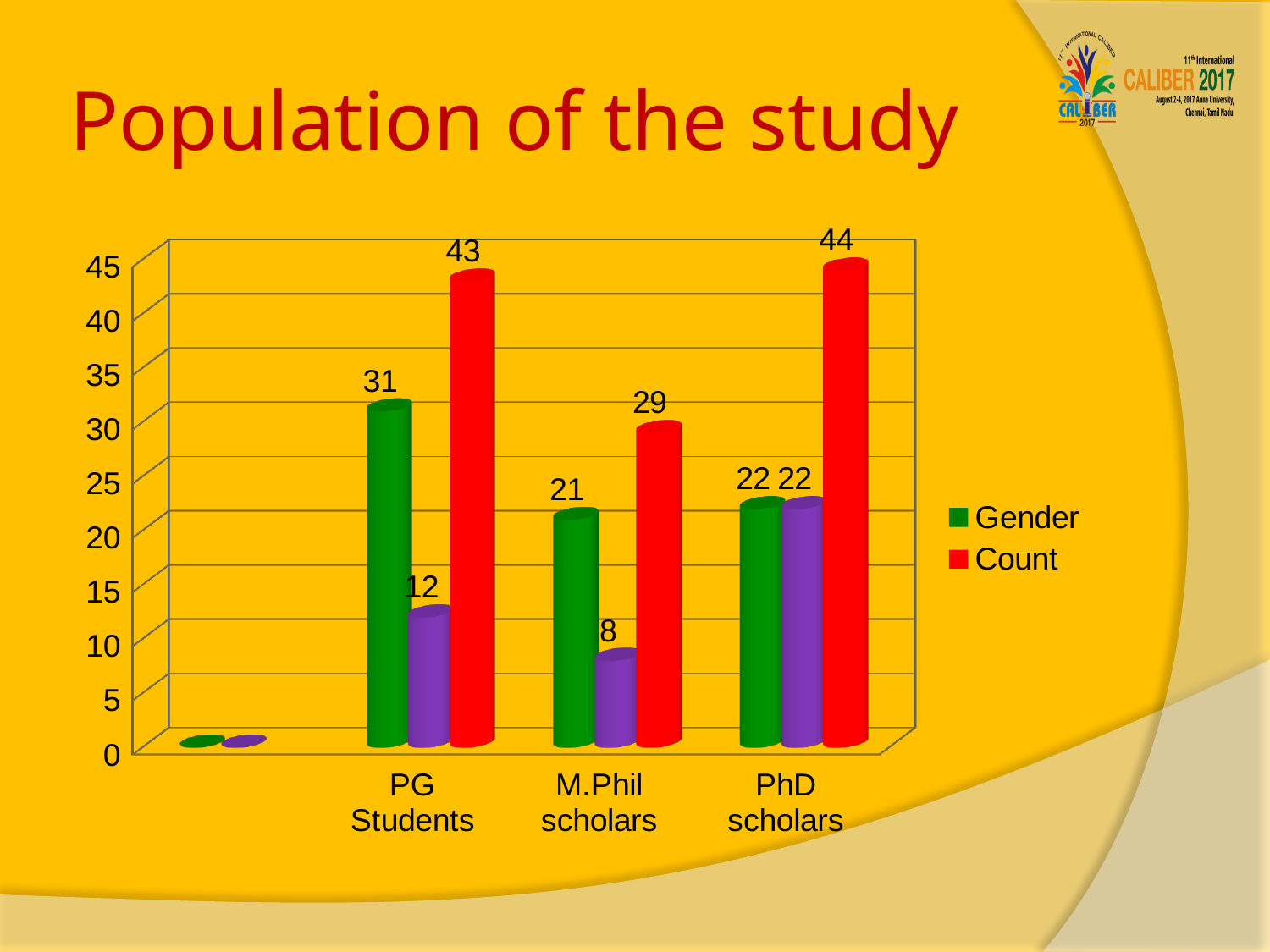
How many series does the legend list? 2 What is the Count value for PG Students? 43 What is the Count value for PhD scholars? 44 What kind of chart is shown on the slide? bar chart What is the Gender value for PG Students? 31 What is the Gender value for M.Phil scholars? 21 Which category has the lowest Count value? M.Phil scholars Which has the larger Gender value, PG Students or PhD scholars? PG Students What is the Count value for M.Phil scholars? 29 Which category has the highest Count value? PhD scholars What is the difference between the Count values for PhD scholars and M.Phil scholars? 15 What colour represents the Count series in the legend? red